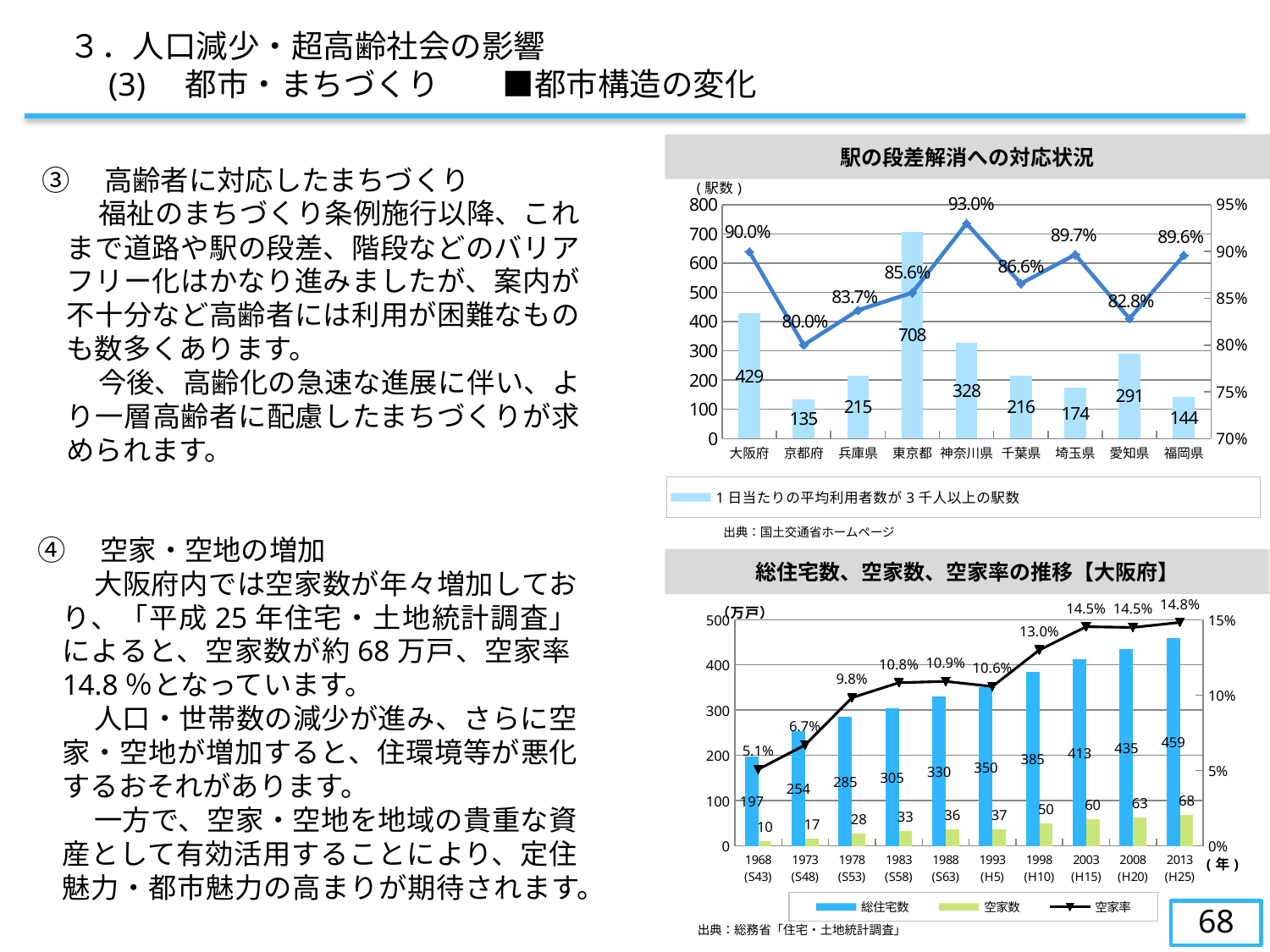
In the chart titled 総住宅数、空家数、空家率の推移【大阪府】, what is the 空家率 for 1998? 13.0% In the chart titled 総住宅数、空家数、空家率の推移【大阪府】, how many series does the legend list? 3 In the chart titled 駅の段差解消への対応状況, which prefecture has the lowest number of stations? 京都府 In the chart titled 駅の段差解消への対応状況, what is the percentage shown for 神奈川県? 93.0% In the chart titled 駅の段差解消への対応状況, what is the number of stations for 東京都? 708 In the chart titled 駅の段差解消への対応状況, how many prefectures are shown on the x axis? 9 In the chart titled 総住宅数、空家数、空家率の推移【大阪府】, what is the difference in 総住宅数 between 2013 and 1968? 262 In the chart titled 駅の段差解消への対応状況, which prefecture has the lowest percentage on the line? 京都府 In the chart titled 総住宅数、空家数、空家率の推移【大阪府】, what is the 総住宅数 value for 1988? 330 In the chart titled 駅の段差解消への対応状況, what is the difference in station count between 大阪府 and 愛知県? 138 In the chart titled 総住宅数、空家数、空家率の推移【大阪府】, what is the 空家数 value for 2013? 68 In the chart titled 総住宅数、空家数、空家率の推移【大阪府】, does 総住宅数 rise or fall from 1968 to 2013? rise